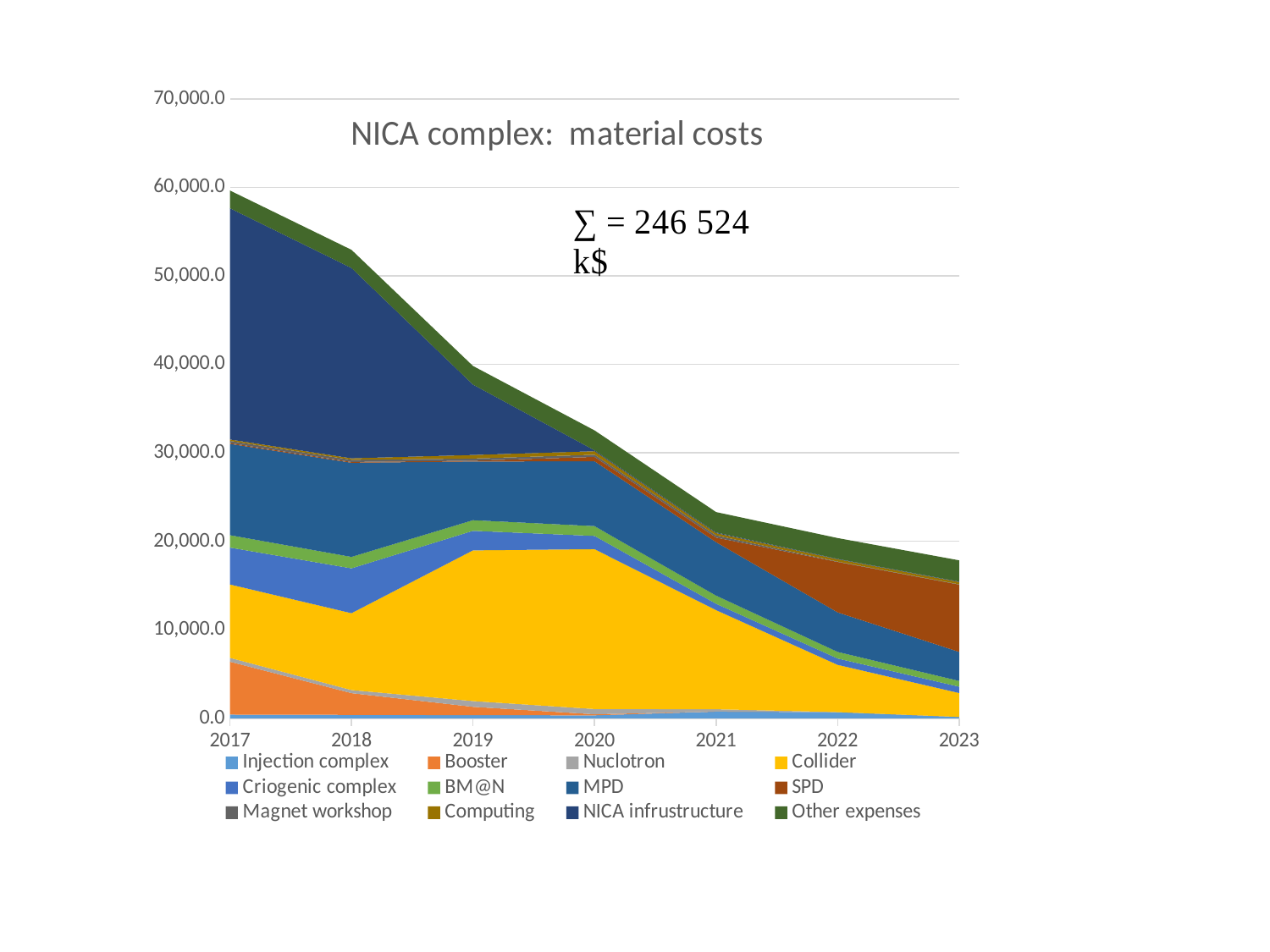
Is the total material cost for 2021 greater or less than 30,000.0? less What overall sum is annotated on the chart? ∑ = 246 524 k$ How many series does the legend list? 12 Is the total material cost for 2017 greater or less than 50,000.0? greater Which year has the lowest total material cost? 2023 Which year has the highest total material cost? 2017 How many years are shown along the x axis? 7 Is the total material cost for 2019 greater or less than 30,000.0? greater What is the title of the chart? NICA complex: material costs Do the total material costs rise or fall from 2017 to 2023? Fall What kind of chart is shown on the slide? Stacked area chart